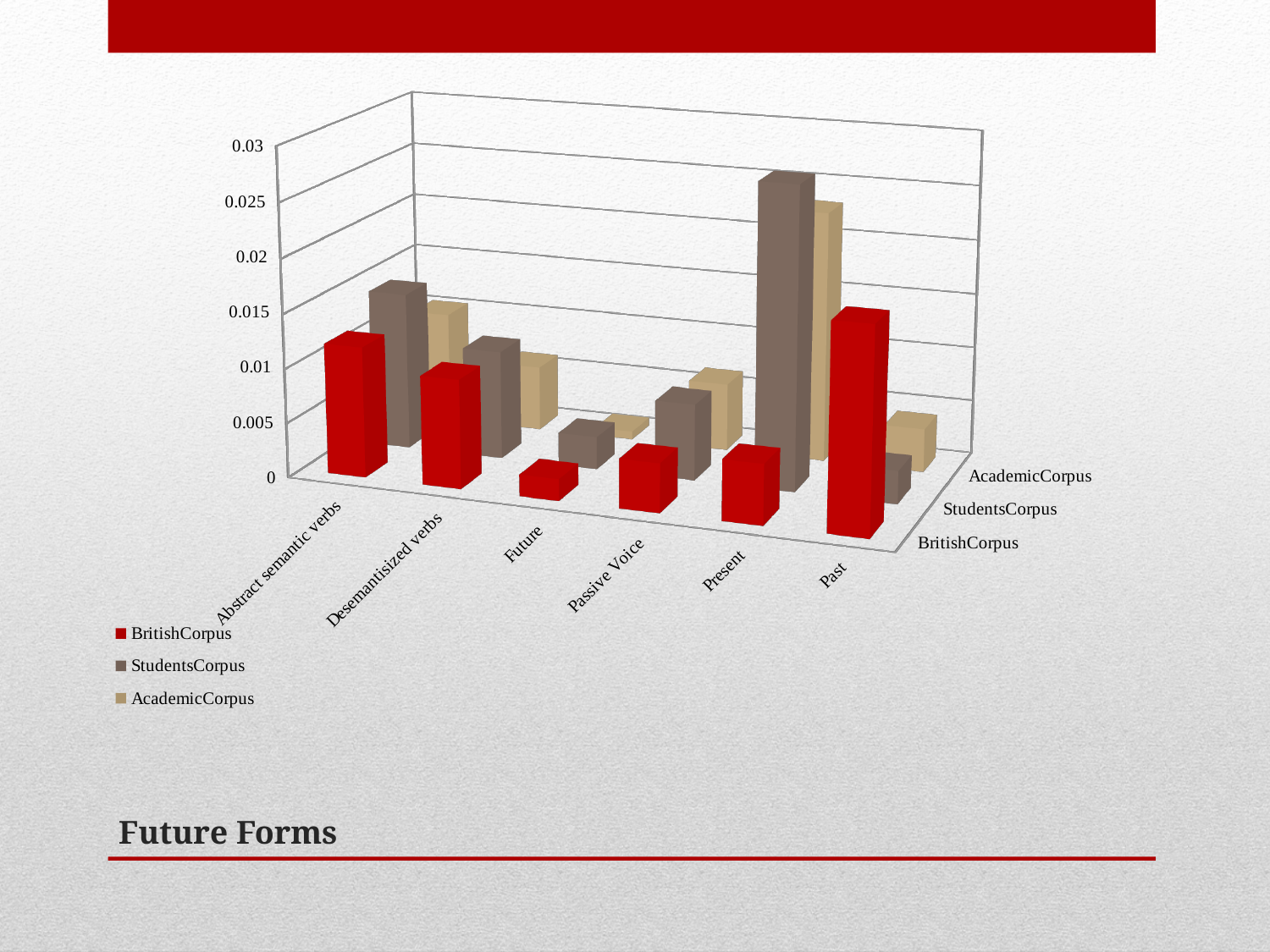
For the Present category, which series has the larger value: StudentsCorpus or BritishCorpus? StudentsCorpus How many series does the chart's legend list? 3 How many categories are shown along the x axis of the chart? 6 Is the BritishCorpus value for Future greater or less than 0.005? less For the Past category, which series has the larger value: BritishCorpus or StudentsCorpus? BritishCorpus For which category is the AcademicCorpus value highest? Present For which category is the StudentsCorpus value highest? Present What kind of chart is shown on the slide? bar chart For which category is the BritishCorpus value lowest? Future Which colour represents the BritishCorpus series in the chart? red Is the StudentsCorpus value for Present greater or less than 0.02? greater